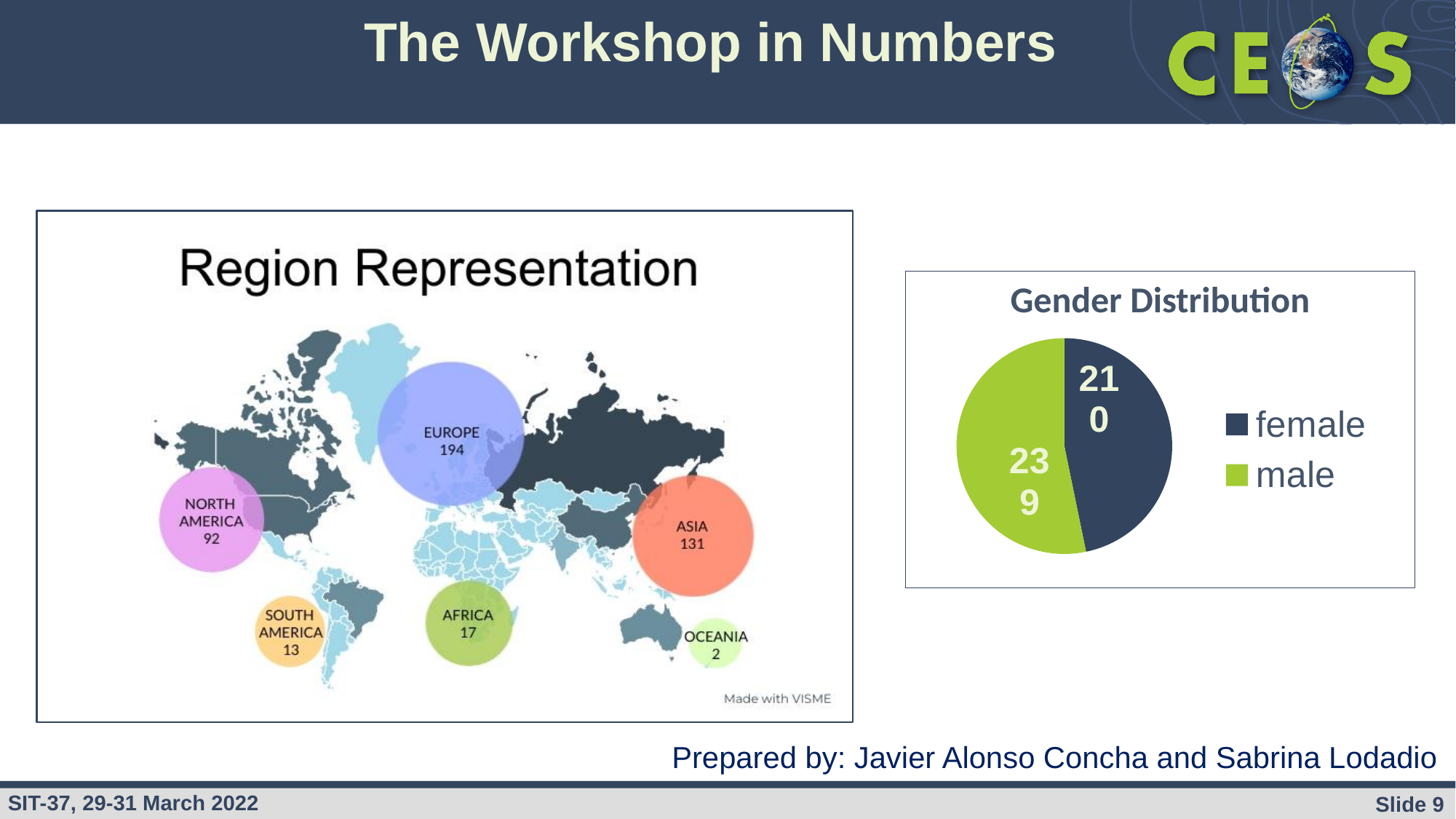
In the Region Representation chart, which region has the highest value? Europe In the Region Representation chart, what is the value for South America? 13 In the Region Representation chart, how many participants are from Europe? 194 How many regions are shown in the Region Representation chart? 6 In the Gender Distribution chart, what is the value for female? 210 In the Region Representation chart, what is the value for Asia? 131 What kind of chart is the Gender Distribution chart? Pie chart In the Gender Distribution chart, what is the total of female and male? 449 In the Region Representation chart, which is larger, North America or Africa? North America In the Gender Distribution chart, what is the value for male? 239 In the Region Representation chart, what is the difference between Europe and Asia? 63 In the Region Representation chart, which region has the lowest value? Oceania